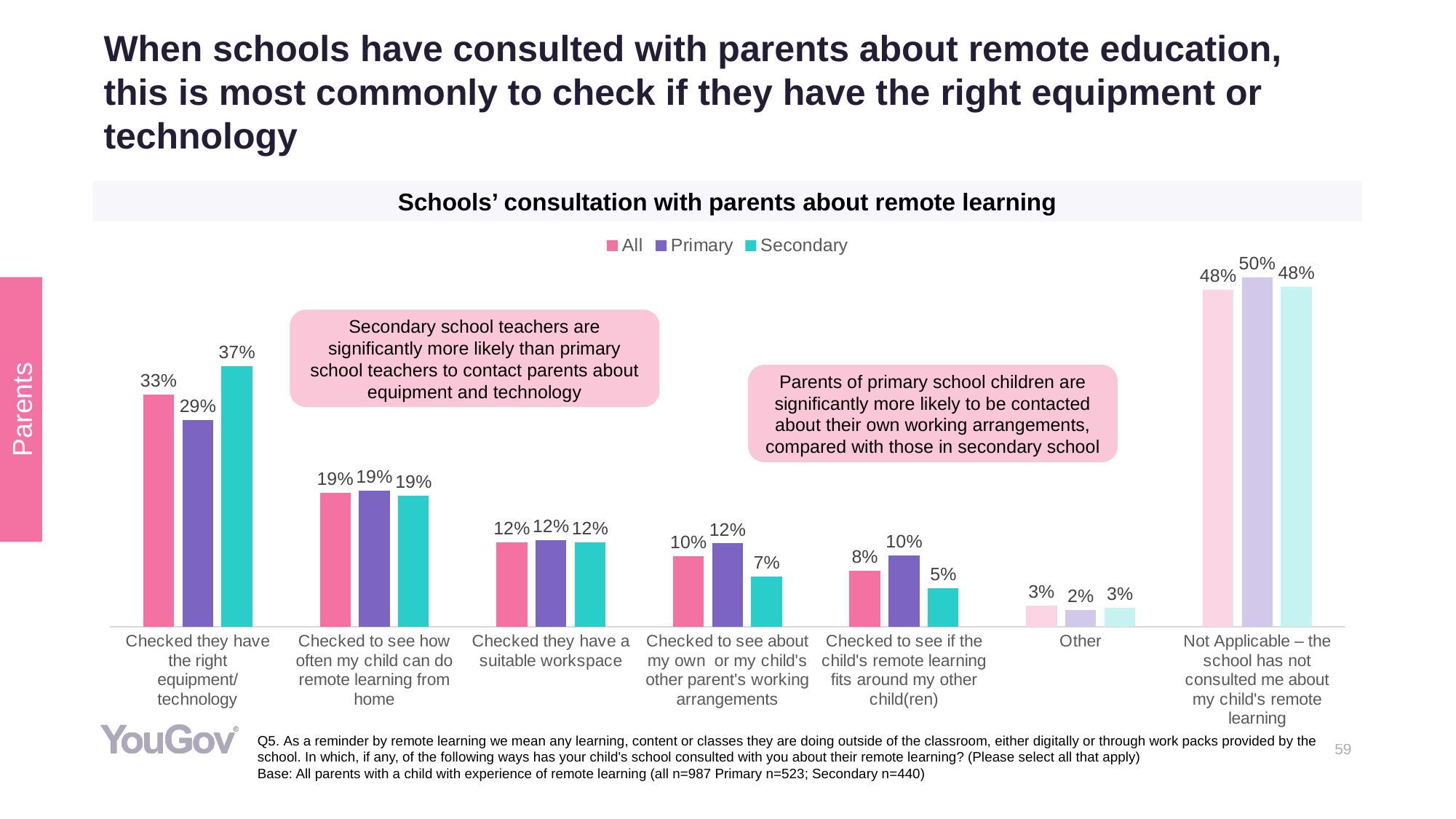
What is the title of the chart? Schools' consultation with parents about remote learning Which category has the highest value for the Primary series? Not Applicable – the school has not consulted me about my child's remote learning What is the value for All for 'Checked to see if the child's remote learning fits around my other child(ren)'? 8% What is the value for Primary for 'Checked to see about my own or my child's other parent's working arrangements'? 12% How many categories are shown on the x axis? 7 Which is larger for 'Checked to see if the child's remote learning fits around my other child(ren)': the Primary value or the Secondary value? Primary What kind of chart is shown on the slide? Bar chart Which category has the lowest value for the Secondary series? Other How many series does the legend list? 3 What are the three series listed in the legend? All, Primary, Secondary What is the value for Secondary for 'Checked they have the right equipment/technology'? 37% What is the difference between the Secondary and Primary values for 'Checked they have the right equipment/technology'? 8 percentage points